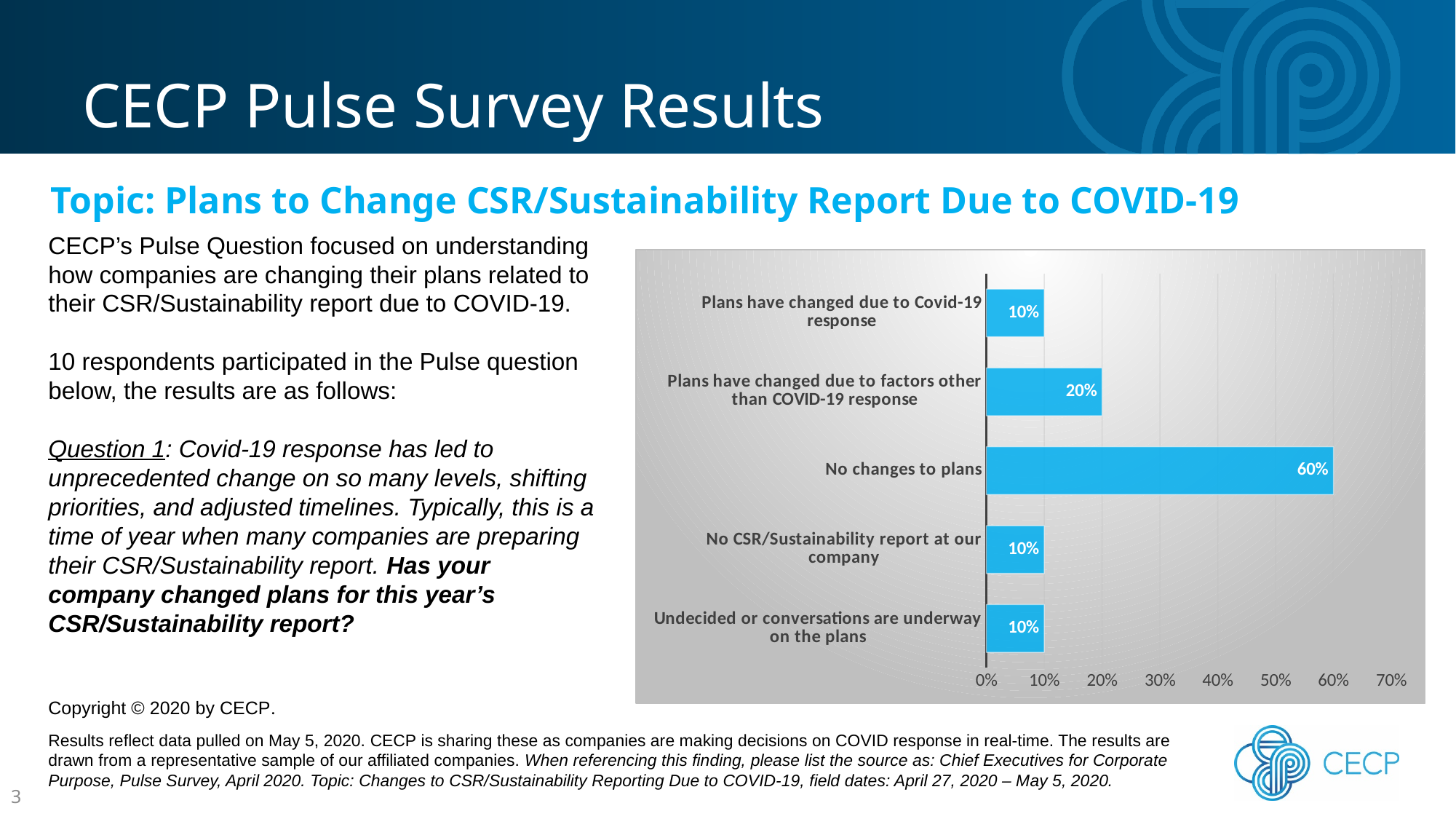
What percentage of respondents reported no changes to plans? 60% What is the difference between 'No changes to plans' and 'Plans have changed due to factors other than COVID-19 response'? 40% What is the value for 'Plans have changed due to Covid-19 response'? 10% Which category has the highest value? No changes to plans Which is larger: 'Plans have changed due to factors other than COVID-19 response' or 'No CSR/Sustainability report at our company'? Plans have changed due to factors other than COVID-19 response What is the value for 'Plans have changed due to factors other than COVID-19 response'? 20% Is the value for 'No changes to plans' greater or less than 50%? greater What is the maximum value shown on the x axis of the chart? 70% How many categories have a value of 10%? 3 What kind of chart is shown on the slide? bar chart How many categories are shown in the chart? 5 What is the value for 'Undecided or conversations are underway on the plans'? 10%